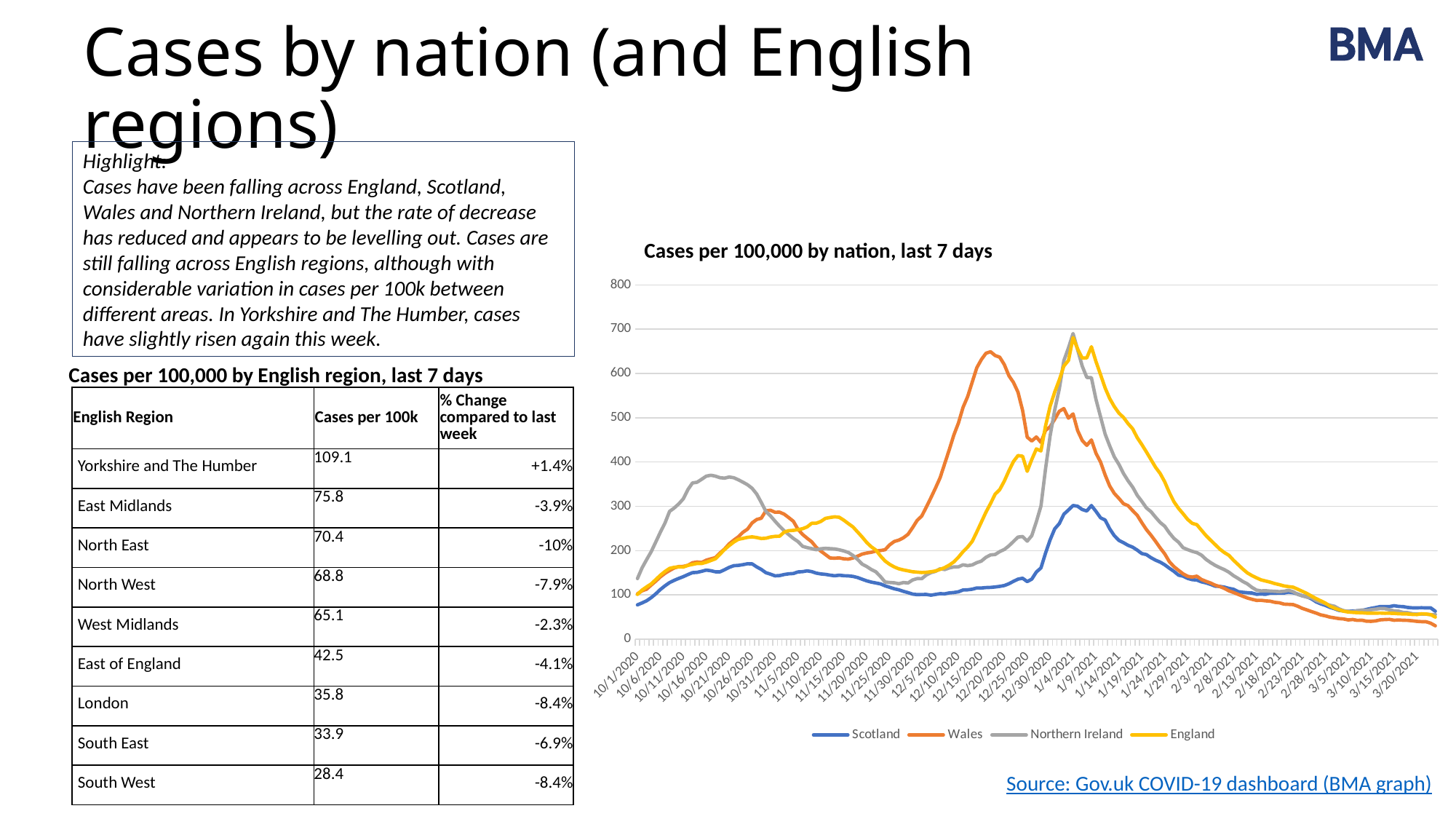
Is the value for Northern Ireland around 10/16/2020 greater or less than 300? greater Around 10/16/2020, which is higher: Northern Ireland or Scotland? Northern Ireland Is the peak value for Scotland greater or less than 400? less What kind of chart is shown on the slide? Line chart Which colour represents Wales in the chart? Orange Is the value for Scotland at 10/1/2020 greater or less than 100? less Around 12/15/2020, which is higher: Wales or Scotland? Wales What is the title of the chart? Cases per 100,000 by nation, last 7 days Which nation has the lowest peak value in the chart? Scotland How many series does the legend of the chart list? 4 Do the values for England rise or fall between 1/9/2021 and 3/20/2021? Fall